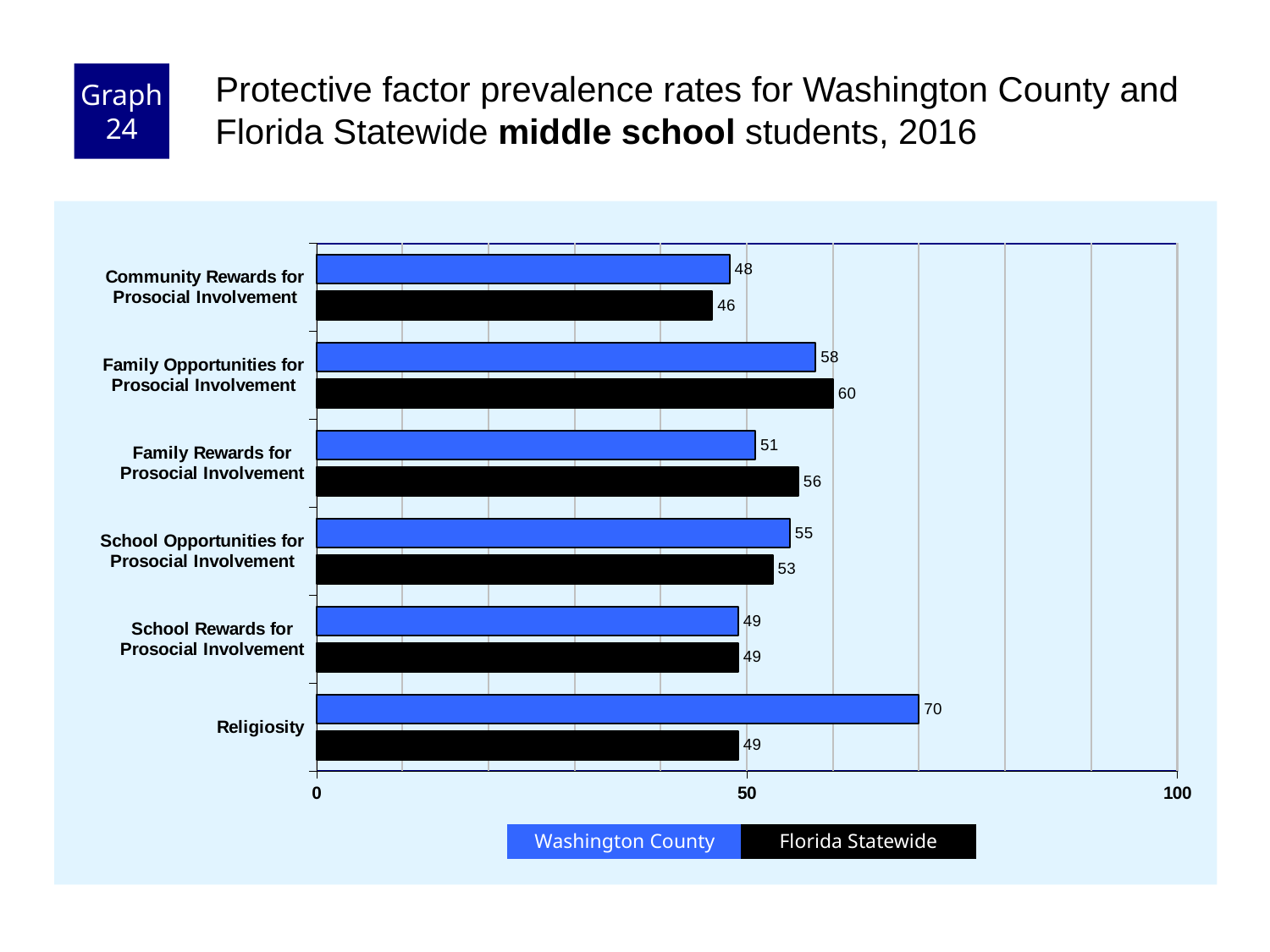
Is the Florida Statewide value for Family Opportunities for Prosocial Involvement greater or less than 50? greater What is the Washington County value for Community Rewards for Prosocial Involvement? 48 What is the Florida Statewide value for Family Opportunities for Prosocial Involvement? 60 What kind of chart is shown on the slide? bar chart What is the difference between the Washington County and Florida Statewide values for Religiosity? 21 For School Opportunities for Prosocial Involvement, which is larger: Washington County or Florida Statewide? Washington County Which category has the lowest Florida Statewide value? Community Rewards for Prosocial Involvement Which category has the highest Washington County value? Religiosity What is the Washington County value for Religiosity? 70 What is the difference between the Florida Statewide and Washington County values for Family Rewards for Prosocial Involvement? 5 How many categories are shown on the chart? 6 How many series does the legend list? 2